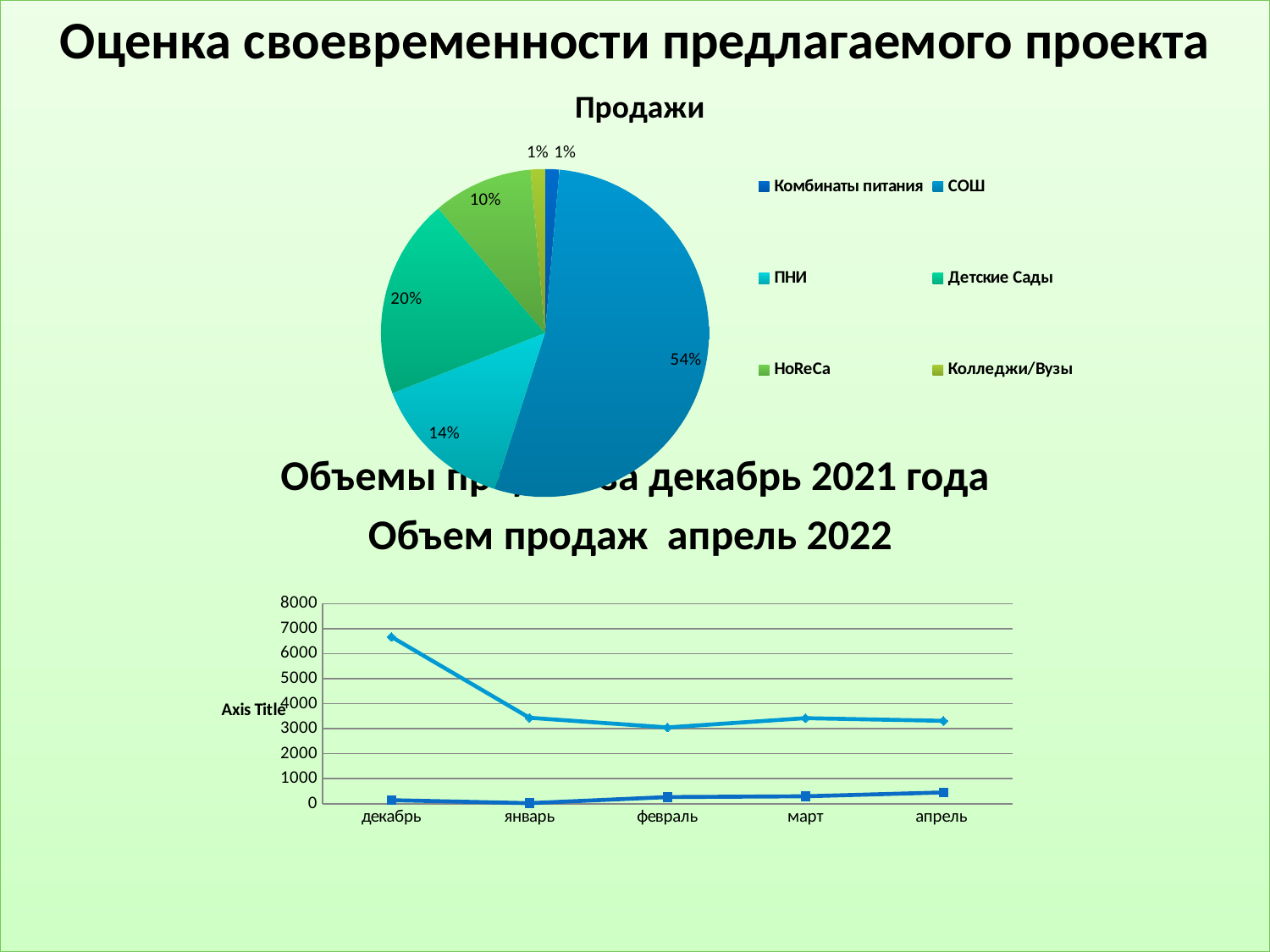
In the pie chart titled Продажи, what share does HoReCa have? 10% In the pie chart titled Продажи, how many categories does the legend list? 6 What kind of chart is the upper chart titled Продажи? Pie chart What kind of chart is the lower chart titled Объем продаж апрель 2022? Line chart In the lower chart titled Объем продаж апрель 2022, is the value of the upper line for декабрь greater or less than 6000? greater In the pie chart titled Продажи, what is the difference in percentage points between the СОШ slice and the Детские Сады slice? 34% In the lower chart titled Объем продаж апрель 2022, does the upper line rise or fall from декабрь to январь? fall In the pie chart titled Продажи, what share does ПНИ have? 14% In the pie chart titled Продажи, which category has the largest slice? СОШ In the pie chart titled Продажи, what share does СОШ have? 54% In the lower chart titled Объем продаж апрель 2022, how many months are shown on the x axis? 5